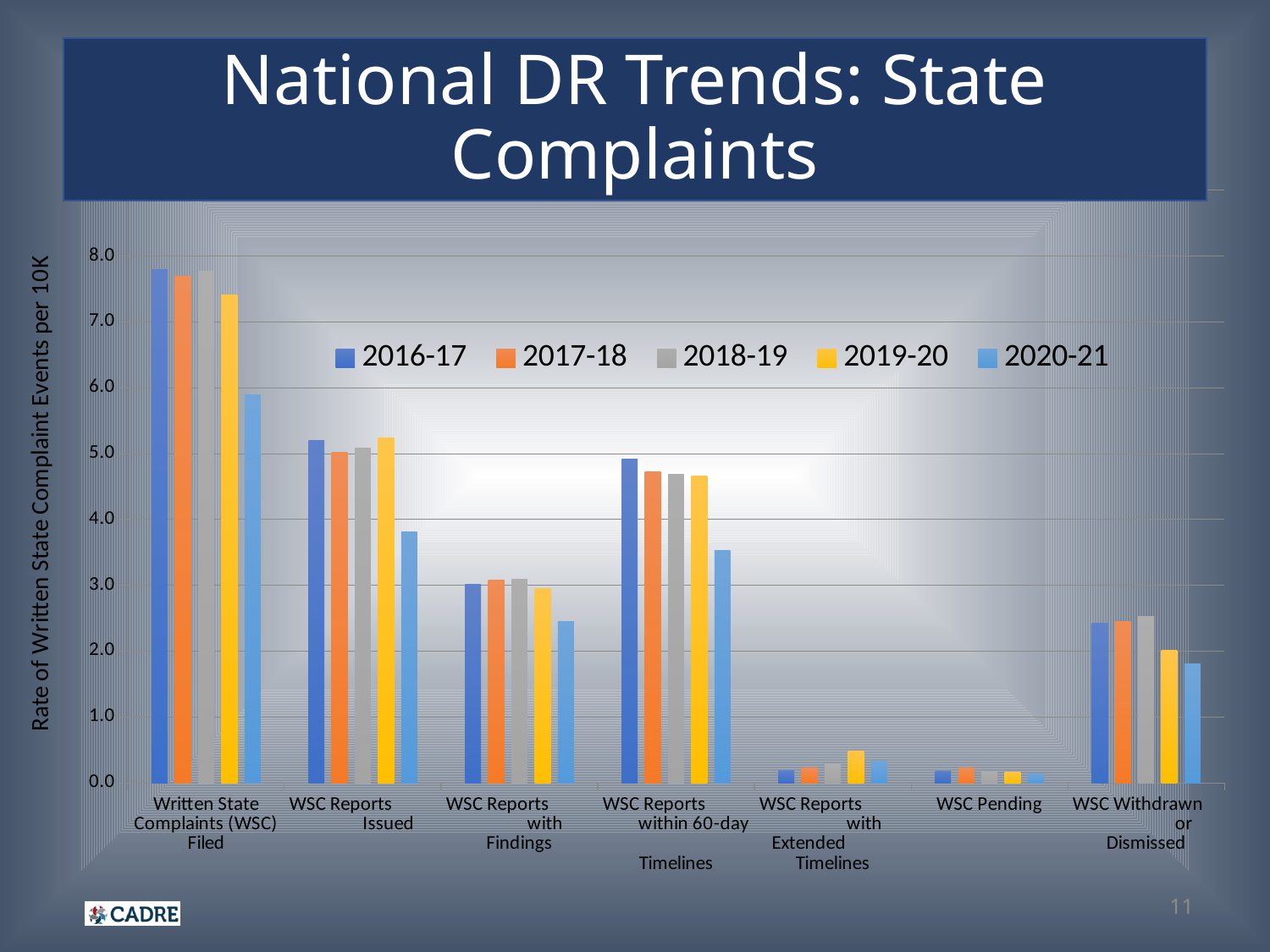
Across the years from 2016-17 to 2020-21, do the values for WSC Reports Issued overall rise or fall? fall Which is larger for WSC Reports within 60-day Timelines: the 2016-17 value or the 2020-21 value? 2016-17 Is the 2020-21 value for WSC Reports Issued greater or less than 4.0? less What is the title of the y axis? Rate of Written State Complaint Events per 10K How many categories are shown along the x axis? 7 How many series does the legend list? 5 Within the WSC Reports with Extended Timelines category, which year has the highest value? 2019-20 What kind of chart is shown on the slide? bar chart Is the 2016-17 value for Written State Complaints (WSC) Filed greater or less than 7.0? greater Within the Written State Complaints (WSC) Filed category, which year has the lowest value? 2020-21 Which category has the highest values overall? Written State Complaints (WSC) Filed Is the 2016-17 value for WSC Reports within 60-day Timelines greater or less than 4.0? greater